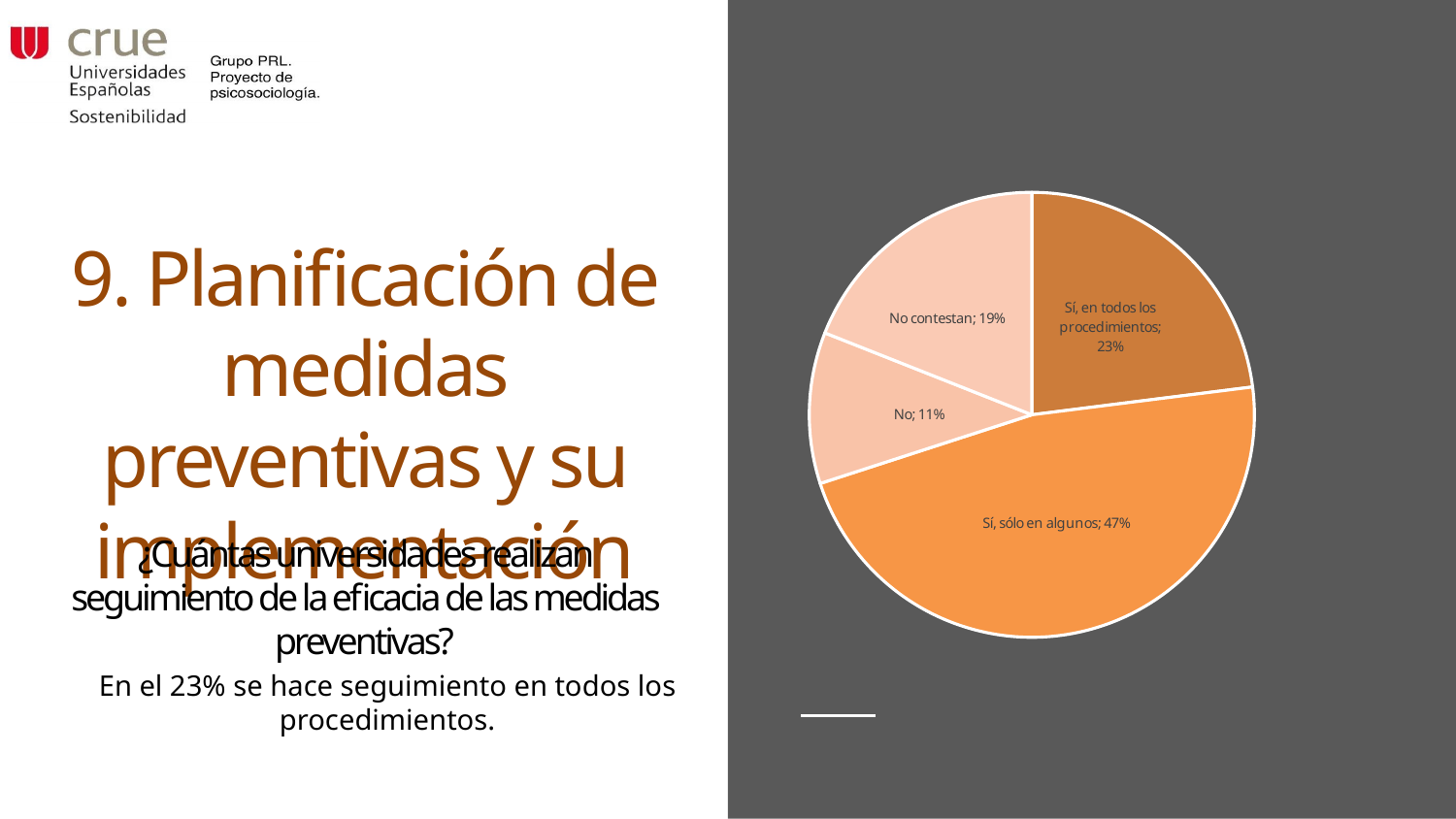
What colour is the "Sí, sólo en algunos" slice of the pie chart? orange What percentage of the pie is labelled "Sí, sólo en algunos"? 47% Which is larger: the "No contestan" slice or the "No" slice? No contestan What kind of chart is shown on the slide? pie chart Which slice of the pie chart is the largest? Sí, sólo en algunos What percentage of the pie is labelled "No contestan"? 19% Which slice of the pie chart is the smallest? No What percentage of the pie is labelled "Sí, en todos los procedimientos"? 23% What percentage of the pie is labelled "No"? 11% How many slices does the pie chart have? 4 What is the combined share of the two "Sí" slices in the pie chart? 70% What is the difference in percentage points between "Sí, sólo en algunos" and "Sí, en todos los procedimientos"? 24